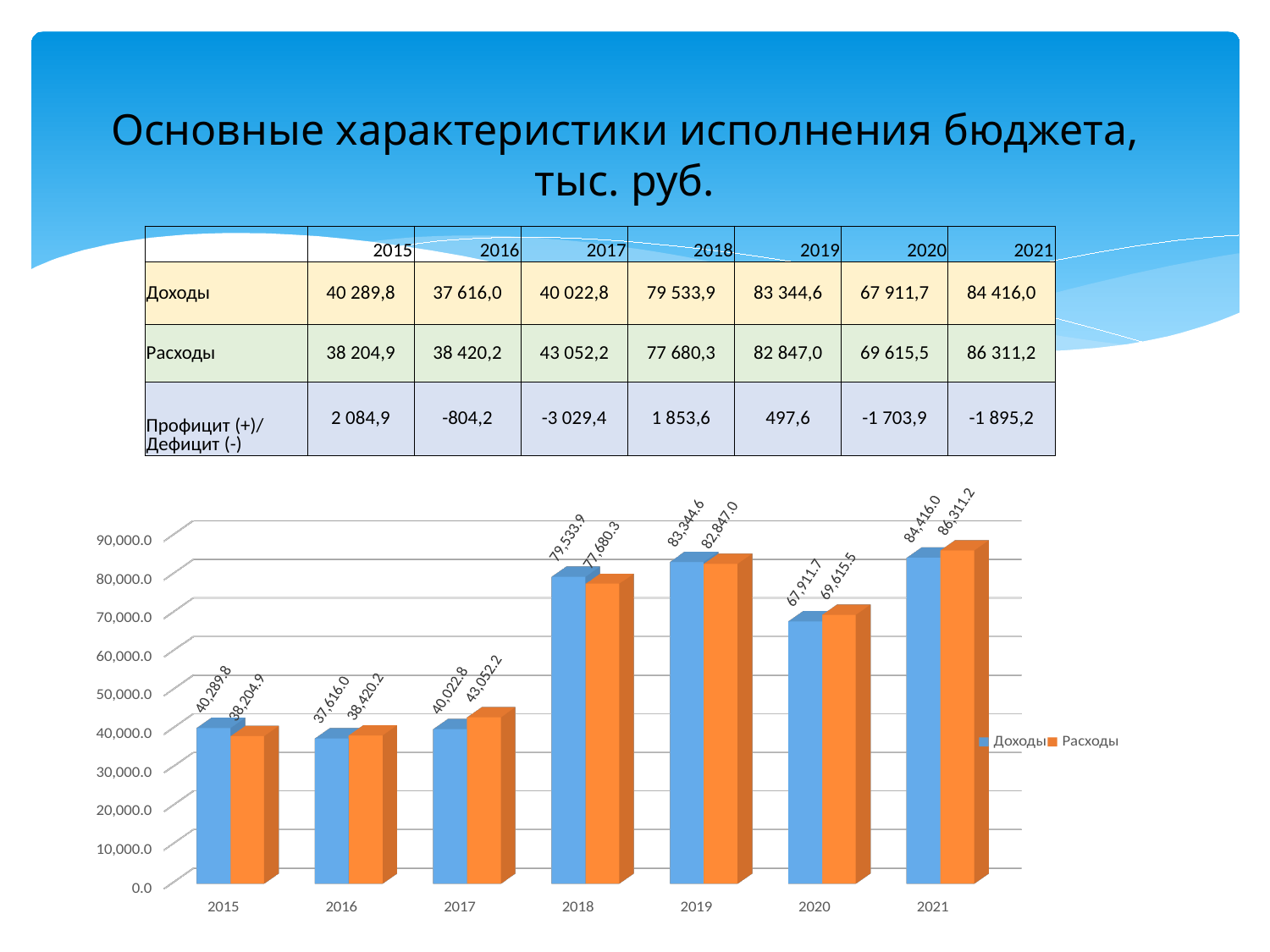
How many years are shown on the x axis of the chart? 7 How many series does the chart legend list? 2 Is the Доходы value for 2018 greater or less than 70,000.0? greater Which year has the lowest Доходы value in the chart? 2016 What type of chart is shown on the slide? bar chart What is the value of Доходы for 2018 in the chart? 79,533.9 What is the value of Расходы for 2020 in the chart? 69,615.5 What is the difference between Расходы and Доходы for 2017 in the chart? 3,029.4 Which year has the highest Расходы value in the chart? 2021 What is the difference between Расходы and Доходы for 2021 in the chart? 1,895.2 What is the value of Доходы for 2015 in the chart? 40,289.8 In 2019, which is larger in the chart: Доходы or Расходы? Доходы